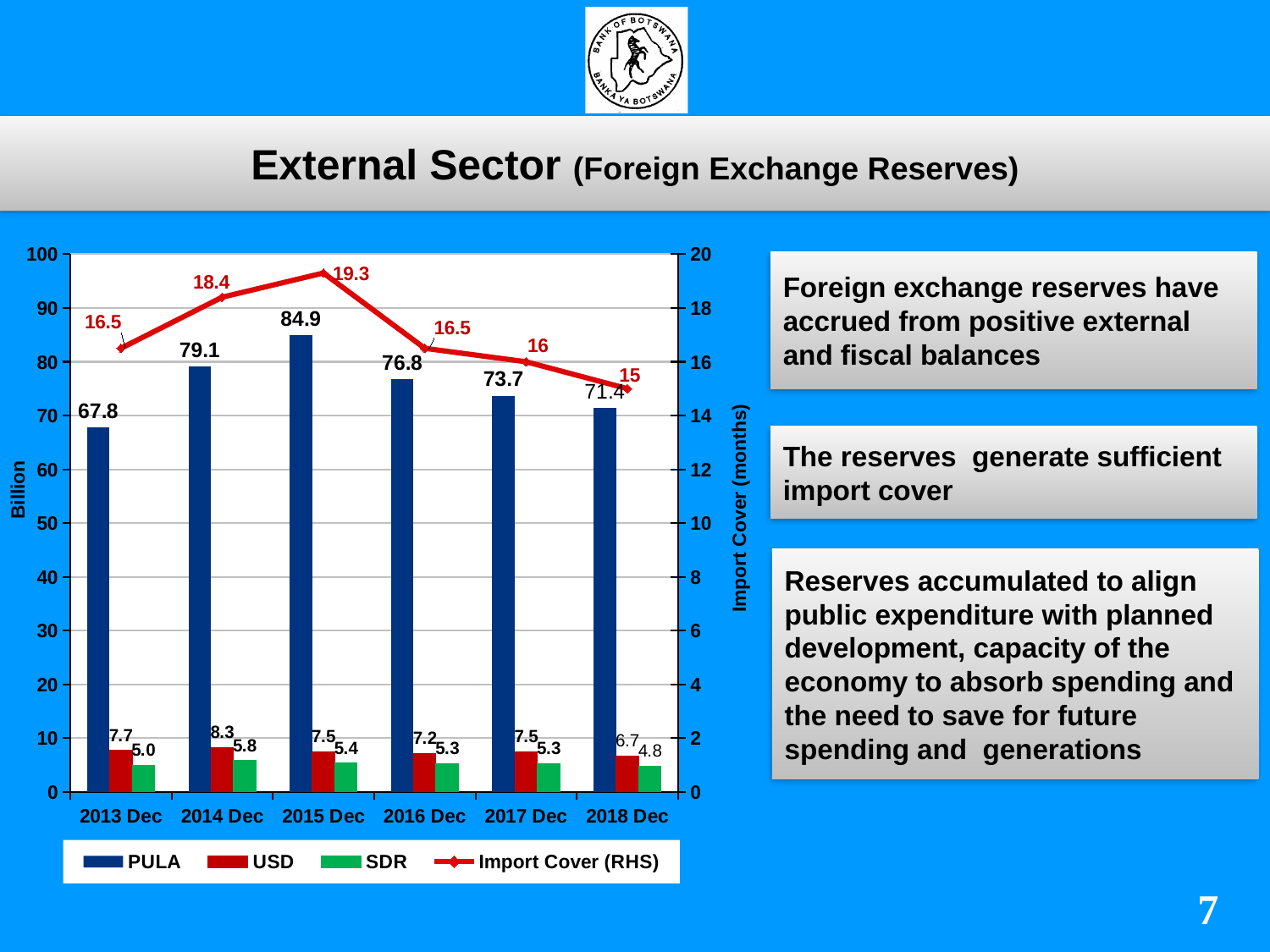
What is the USD value for 2018 Dec? 6.7 In which period is the Import Cover (RHS) value lowest? 2018 Dec In which period is the PULA value highest? 2015 Dec How many series does the legend list? 4 What is the PULA value for 2015 Dec? 84.9 What is the difference between the PULA values for 2015 Dec and 2013 Dec? 17.1 What is the SDR value for 2014 Dec? 5.8 Does the Import Cover (RHS) line rise or fall from 2015 Dec to 2018 Dec? fall What is the Import Cover (RHS) value for 2014 Dec? 18.4 What is the label of the right-hand vertical axis? Import Cover (months) How many time periods are shown on the x axis? 6 Which is larger, the USD value for 2014 Dec or the USD value for 2016 Dec? 2014 Dec